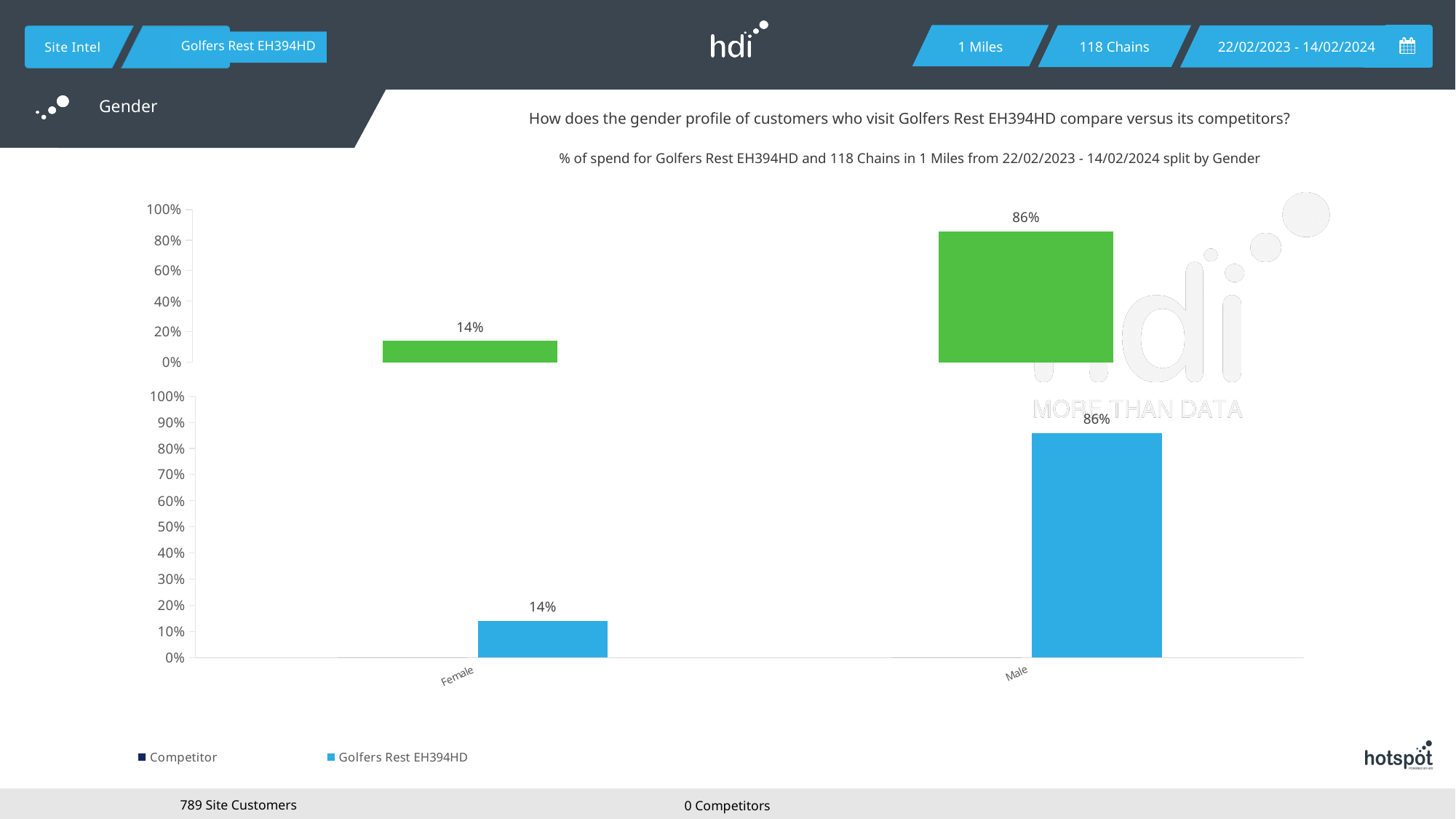
In the bottom chart, how many categories are shown on the x axis? 2 In the bottom chart, what is the difference between the Male and Female values? 72% In the bottom chart, is the value for Male greater or less than 50%? greater In the top chart, what is the value shown on the right bar? 86% How many series does the legend at the bottom of the slide list? 2 In the bottom chart, which category has the lowest value? Female What colour are the bars in the top chart? Green What type of chart is the bottom chart? Bar chart In the bottom chart, what is the value for Male? 86% In the bottom chart, what is the value for Female? 14% In the bottom chart, which category has the highest value? Male In the top chart, what is the value shown on the left bar? 14%